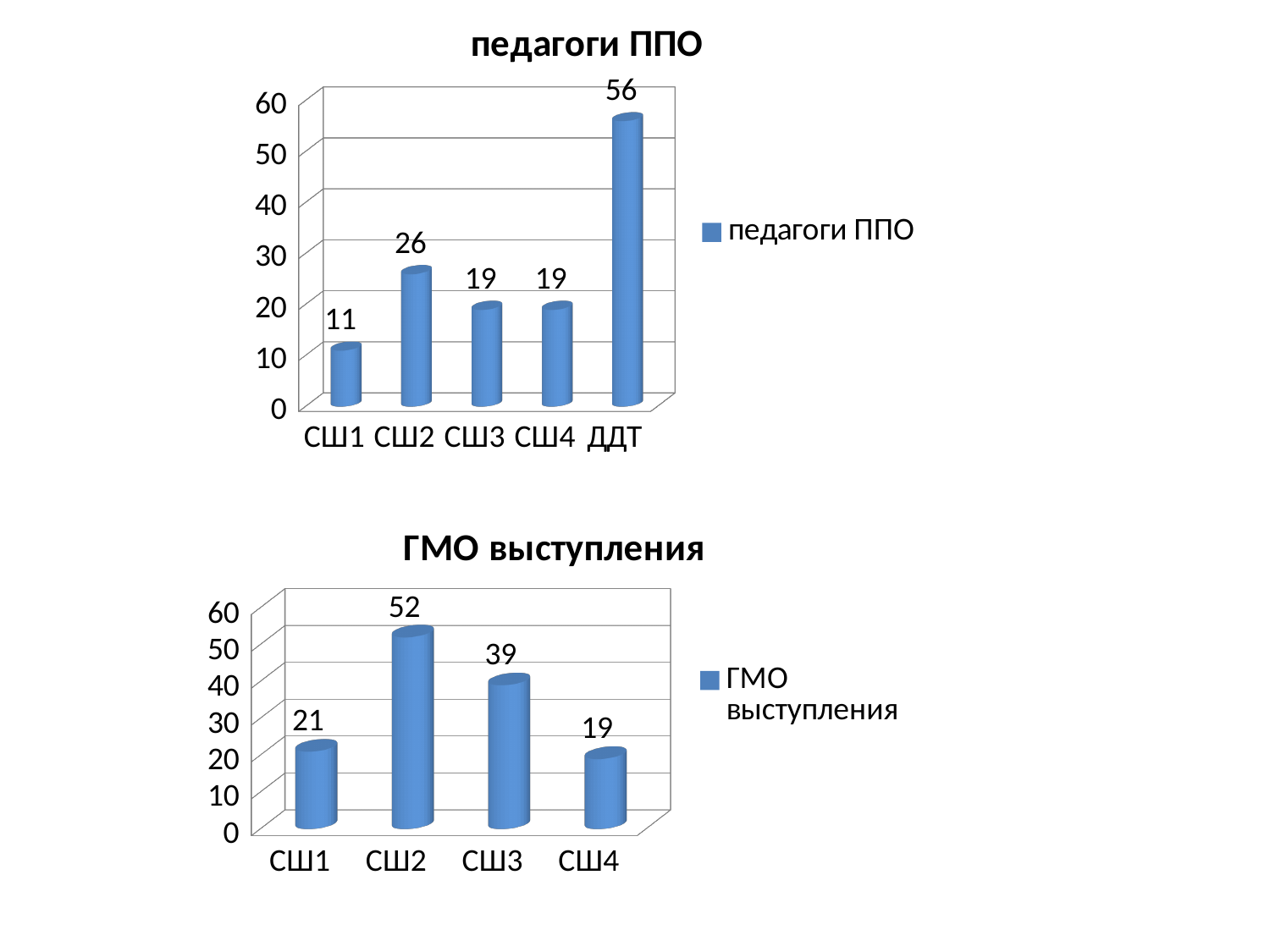
How many series does the legend of the 'педагоги ППО' chart list? 1 In the 'педагоги ППО' chart, what is the value for ДДТ? 56 In the 'педагоги ППО' chart, which category has the lowest value? СШ1 In the 'ГМО выступления' chart, what is the value for СШ3? 39 What kind of chart is the 'ГМО выступления' chart? Bar chart In the 'ГМО выступления' chart, which category has the highest value? СШ2 In the 'ГМО выступления' chart, what is the difference between СШ2 and СШ3? 13 In the 'педагоги ППО' chart, what is the value for СШ2? 26 In the 'ГМО выступления' chart, which is larger, СШ1 or СШ4? СШ1 In the 'педагоги ППО' chart, which category has the highest value? ДДТ In the 'педагоги ППО' chart, what is the difference between ДДТ and СШ1? 45 In the 'педагоги ППО' chart, how many categories are shown on the x axis? 5